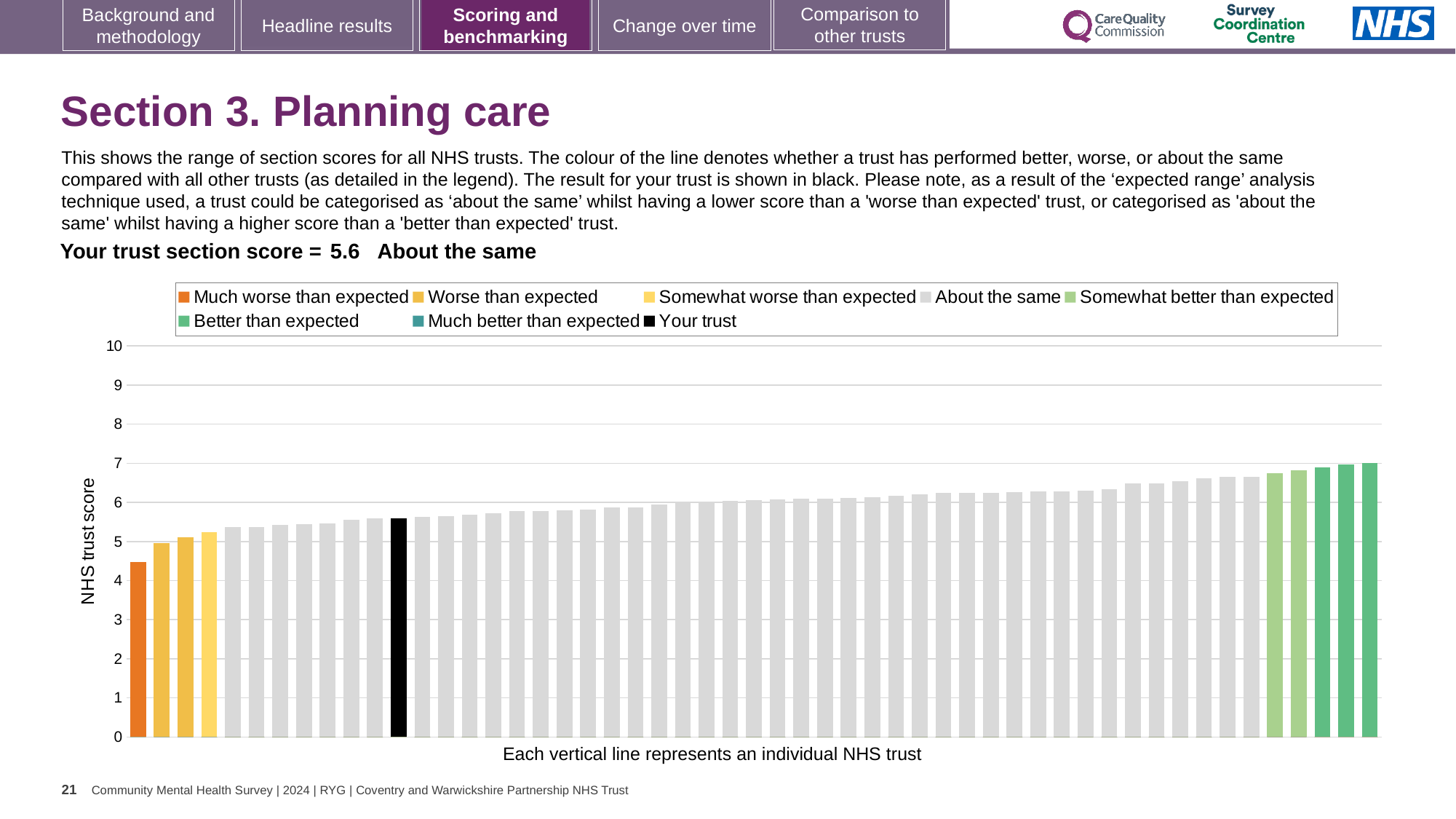
What is the section score for your trust shown on the slide? 5.6 Do the bar values rise or fall from left to right along the x axis? rise How many bars are coloured orange (Much worse than expected)? 1 How many entries does the chart legend list? 8 Is the value of the black 'Your trust' bar greater or less than 5? greater Which is larger: the value of the leftmost bar or the value of the rightmost bar? the rightmost bar Is the value of the leftmost (orange) bar greater or less than 5? less What colour is used for the 'Your trust' bar? black Is the value of the black 'Your trust' bar greater or less than 6? less What is the label on the y axis of the chart? NHS trust score What is the highest value shown on the y axis? 10 What kind of chart is shown on the slide? bar chart